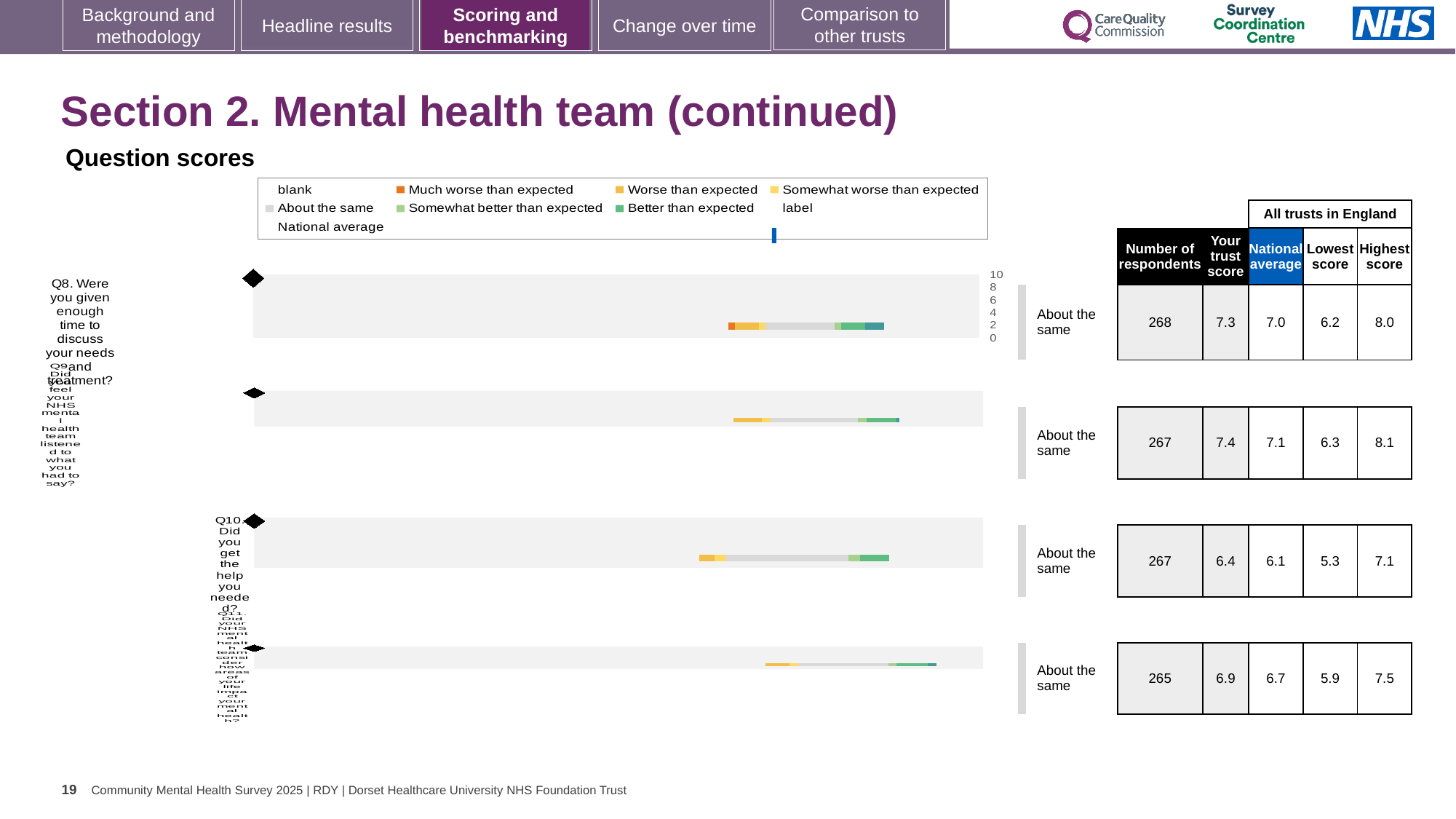
What colour does the legend use for 'Much worse than expected'? orange For the Q8 chart, what is the number of respondents shown? 268 Which question row has the highest 'Your trust score'? Q9 For the Q8 row, what is the difference between the highest score and the lowest score across all trusts in England? 1.8 What kind of chart is used to show the Q8 question score? bar chart What colour does the legend use for 'Better than expected'? green For the Q10 chart, what is the national average score? 6.1 How many question charts (Q8 to Q11) are shown on the slide? 4 What benchmark category is shown next to the Q10 chart? About the same For the Q8 chart, what is 'Your trust score'? 7.3 For the Q8 row, which is larger: 'Your trust score' or the national average? Your trust score Which question row has the lowest 'Your trust score'? Q10